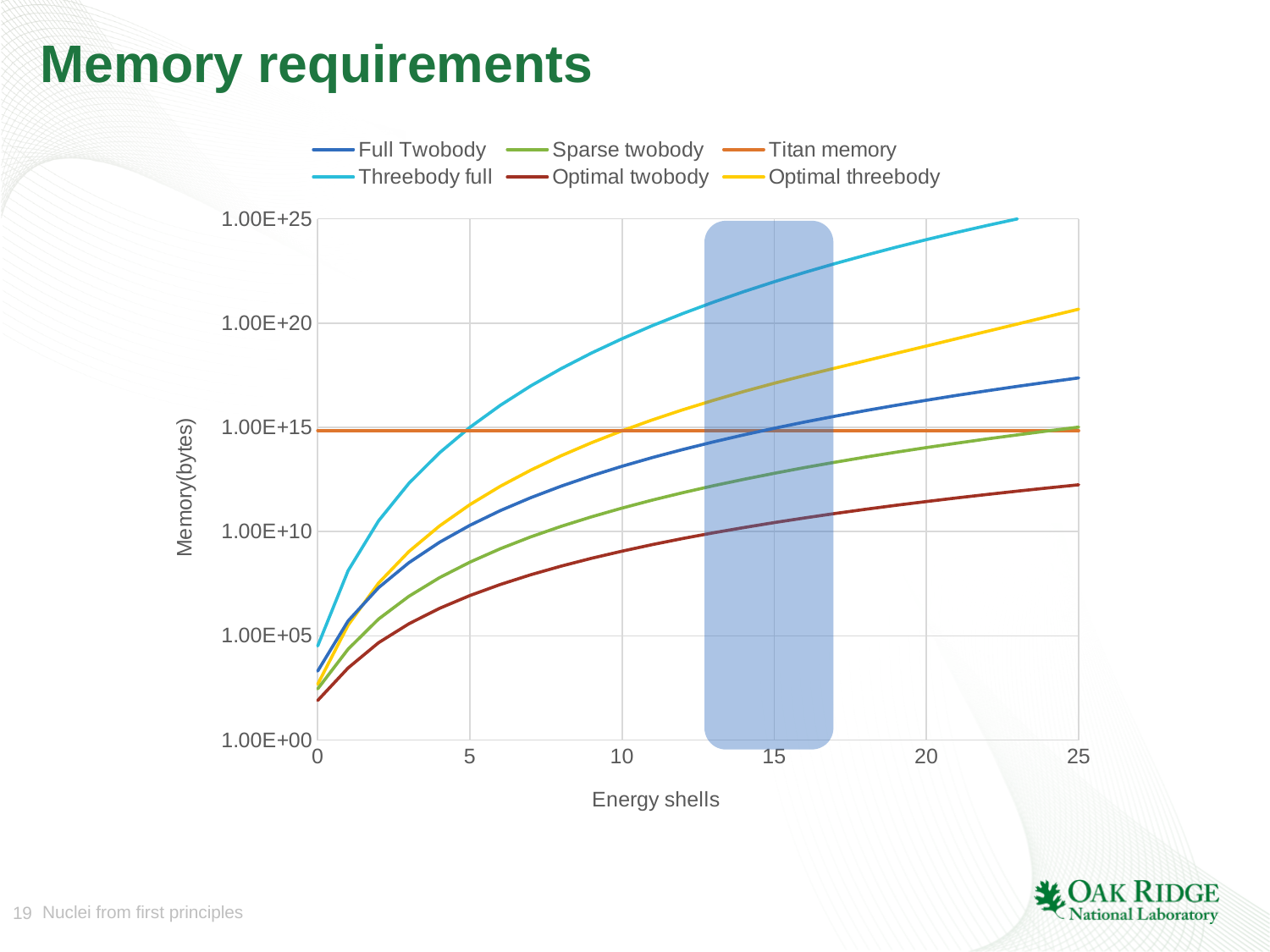
Does the Titan memory series rise, fall, or stay flat as energy shells increase? stay flat Which series has the highest memory at 20 energy shells? Threebody full What kind of chart is shown on the slide? line chart How many series does the legend list? 6 Is the value for Optimal twobody at 25 energy shells greater or less than 1.00E+15? less Is the value for Threebody full at 10 energy shells greater or less than 1.00E+15? greater At 10 energy shells, which is larger: Optimal threebody or Full Twobody? Optimal threebody Does the Full Twobody series rise or fall as energy shells increase? rise What is the title of the chart? Memory requirements What is the label of the x axis? Energy shells At 25 energy shells, which is larger: Full Twobody or Sparse twobody? Full Twobody Which series has the lowest memory at 20 energy shells? Optimal twobody